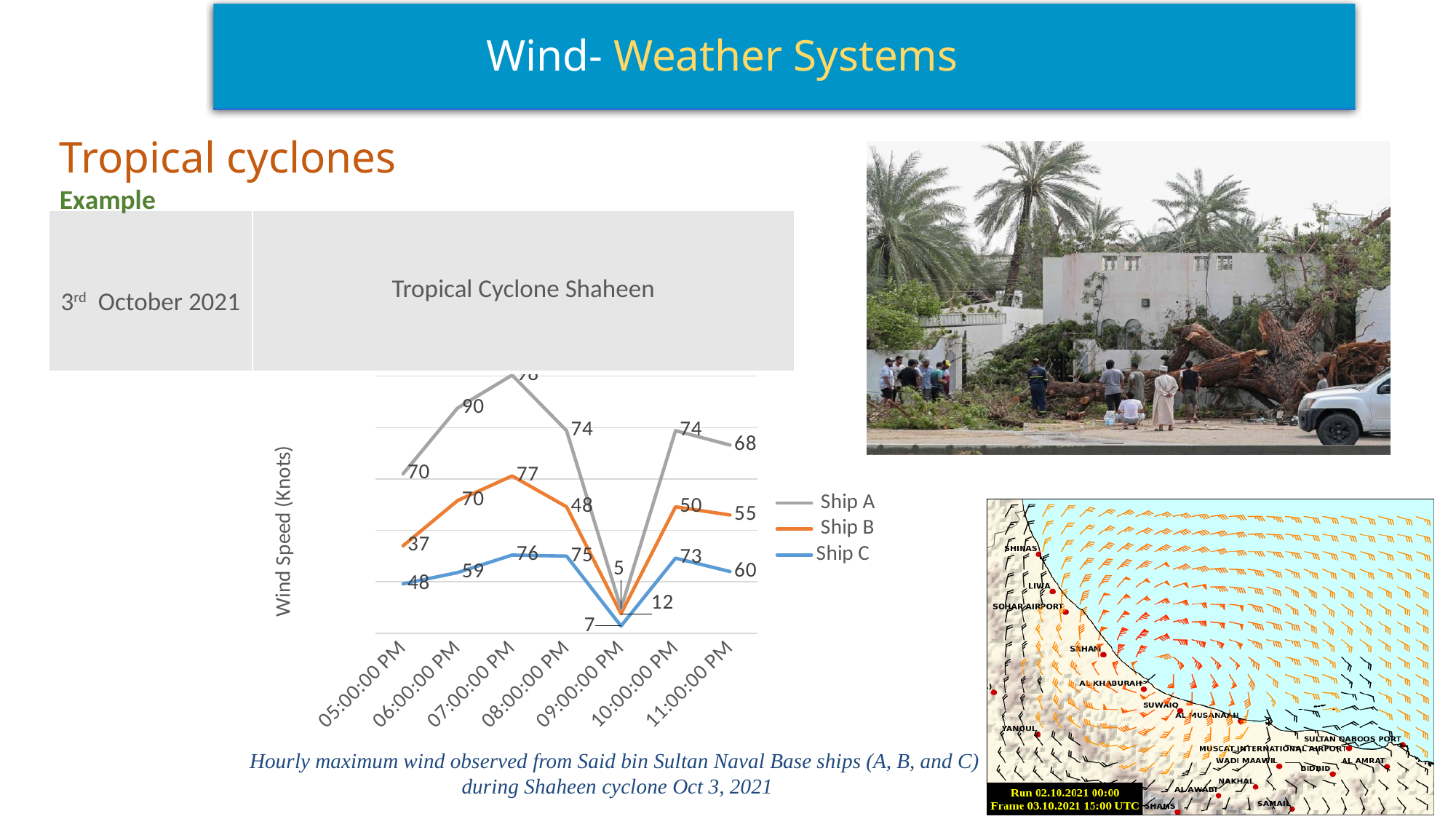
What is the wind speed for Ship B at 11:00:00 PM? 55 How many time points are plotted along the x axis of the wind speed chart? 7 How many series does the legend of the wind speed chart list? 3 At 08:00:00 PM, which has the higher wind speed, Ship B or Ship C? Ship C What is the difference between Ship A and Ship B wind speeds at 06:00:00 PM? 20 At which time does Ship B reach its highest wind speed? 07:00:00 PM What is the wind speed for Ship C at 05:00:00 PM? 48 What is the wind speed for Ship B at 07:00:00 PM? 77 What type of chart is shown on the slide? Line chart At which time does Ship C reach its lowest wind speed? 09:00:00 PM What is the label on the y axis of the wind speed chart? Wind Speed (Knots) What is the wind speed for Ship A at 06:00:00 PM? 90